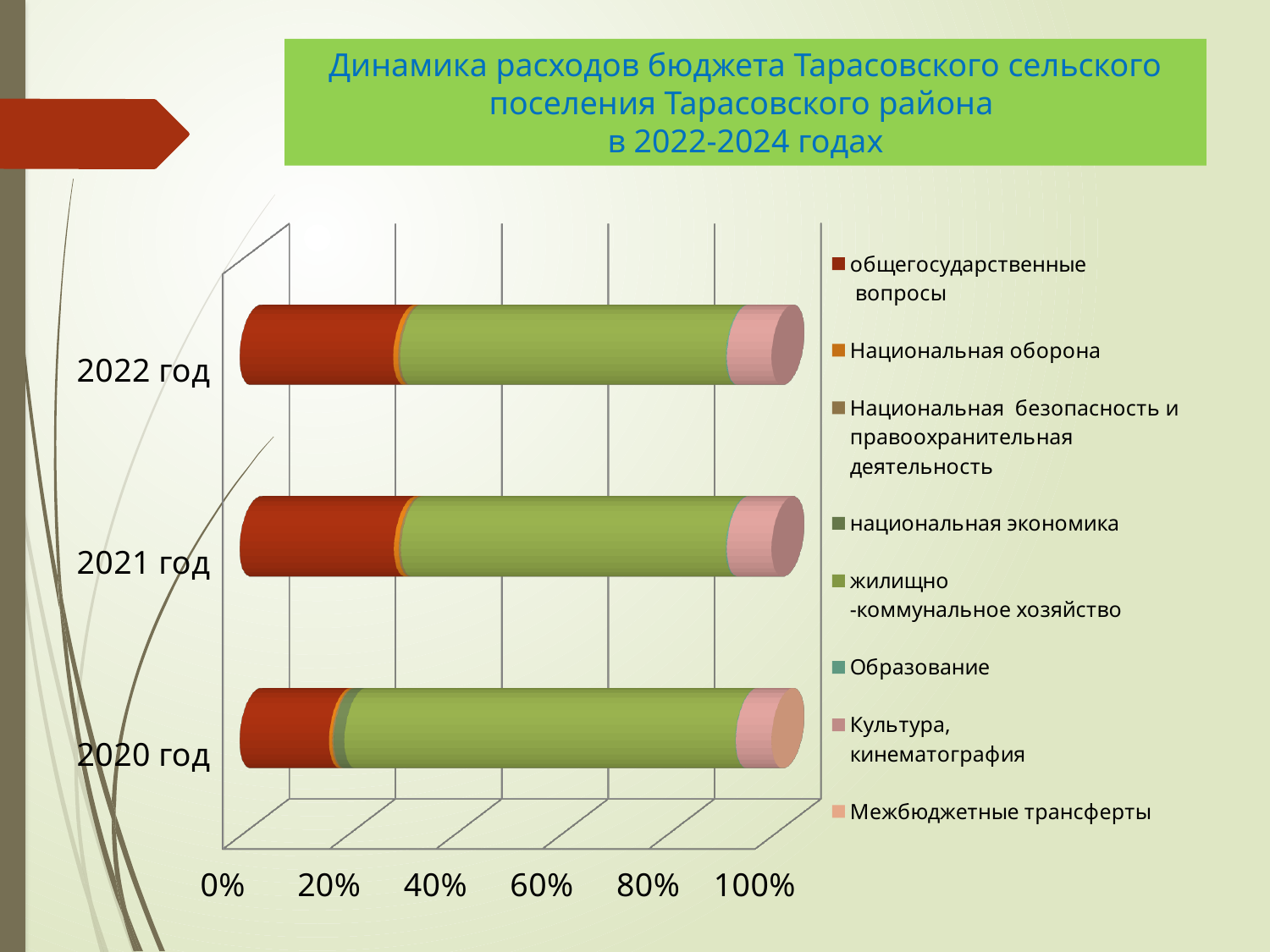
Which legend entry is shown in green? жилищно-коммунальное хозяйство Is the share of общегосударственные вопросы in 2022 год greater or less than 20%? greater Which series takes up the largest share of the bar for 2022 год? жилищно-коммунальное хозяйство How many years (categories) are plotted on the chart? 3 What is the highest value shown on the horizontal axis? 100% What is the title of the chart on the slide? Динамика расходов бюджета Тарасовского сельского поселения Тарасовского района в 2022-2024 годах Is the share of общегосударственные вопросы in 2020 год greater or less than 20%? less Is the share of общегосударственные вопросы larger in 2020 год or in 2022 год? 2022 год Which series takes up the largest share of the bar for 2020 год? жилищно-коммунальное хозяйство Is the share of общегосударственные вопросы in 2021 год greater or less than 20%? greater How many series does the legend list? 8 What kind of chart is shown on the slide? Stacked bar chart